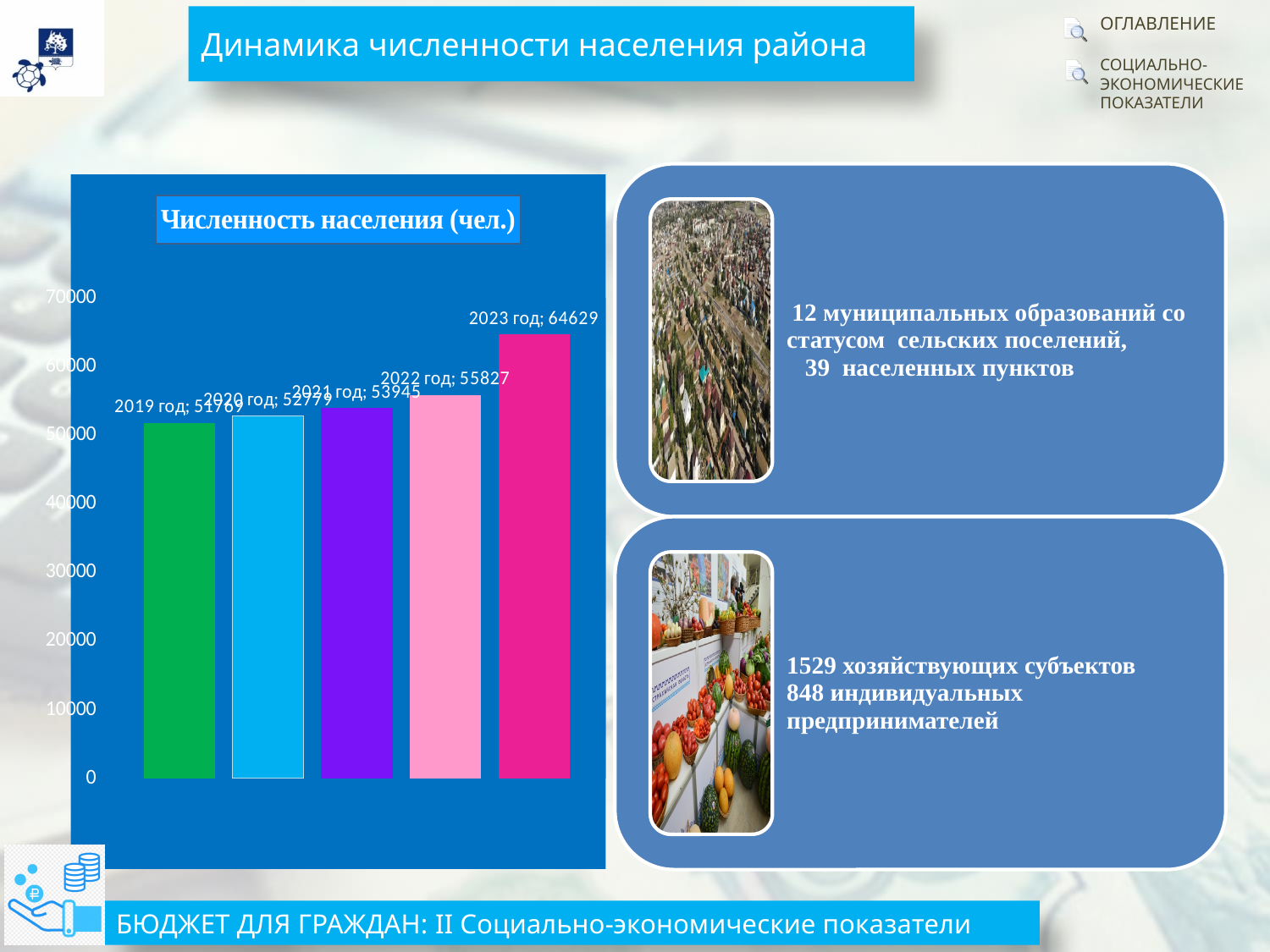
How many years (bars) are plotted in the chart? 5 What is the title of the chart? Численность населения (чел.) What kind of chart is shown on the slide? bar chart What is the population value shown for 2022 год? 55827 Which is larger, the population value for 2022 год or for 2021 год? 2022 год Is the value for 2019 год greater or less than 50000? greater Do the population values rise or fall from 2019 to 2023? rise What is the population value shown for 2023 год? 64629 Which year has the highest population value in the chart? 2023 год Which year has the lowest population value in the chart? 2019 год What is the population value shown for 2021 год? 53945 What is the difference between the population values for 2023 год and 2022 год? 8802